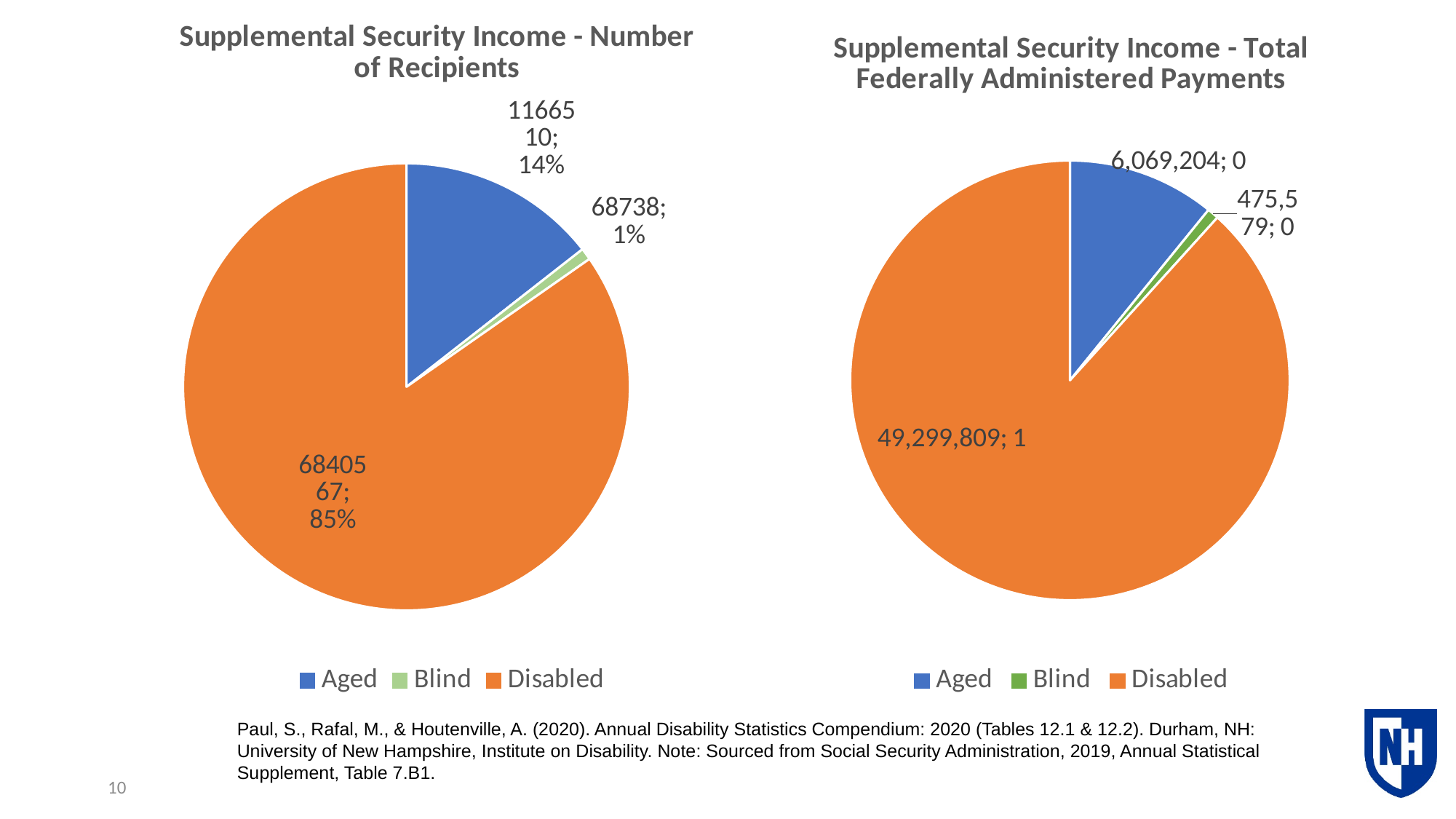
In the 'Supplemental Security Income - Total Federally Administered Payments' chart, what is the value for Disabled? 49,299,809 In the 'Supplemental Security Income - Number of Recipients' chart, what percentage of recipients are Blind? 1% How many categories does the 'Supplemental Security Income - Number of Recipients' chart show? 3 In the 'Supplemental Security Income - Number of Recipients' chart, what percentage of recipients are Disabled? 85% In the 'Supplemental Security Income - Total Federally Administered Payments' chart, which is larger, Aged or Blind? Aged In the 'Supplemental Security Income - Number of Recipients' chart, which category has the smallest slice? Blind In the 'Supplemental Security Income - Number of Recipients' chart, what percentage of recipients are Aged? 14% In the 'Supplemental Security Income - Total Federally Administered Payments' chart, what is the difference between the Disabled and Aged values? 43,230,605 In the 'Supplemental Security Income - Total Federally Administered Payments' chart, what is the value for Blind? 475,579 In the 'Supplemental Security Income - Total Federally Administered Payments' chart, what is the value for Aged? 6,069,204 What type of chart is the 'Supplemental Security Income - Total Federally Administered Payments' chart? Pie chart In the 'Supplemental Security Income - Number of Recipients' chart, which category has the largest slice? Disabled